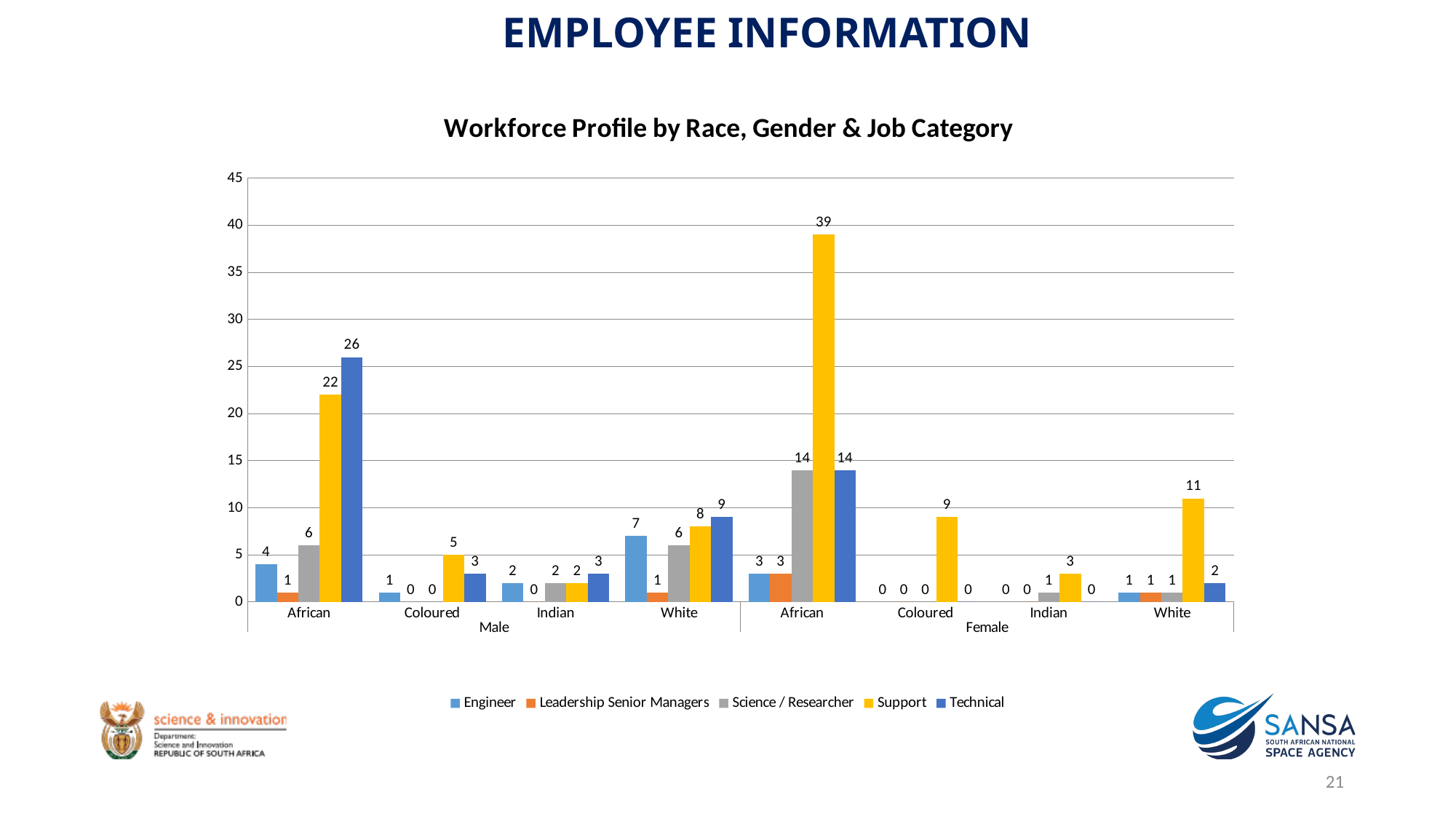
Which race and gender group has the highest Support value? African Female What kind of chart is shown on the slide? bar chart What is the difference between the Support values for African Female and African Male employees? 17 What is the Technical value for African Male employees? 26 How many series does the legend list? 5 What is the title of the chart? Workforce Profile by Race, Gender & Job Category Which is larger: the Technical value for White Male or the Technical value for White Female? White Male What is the Support value for African Female employees? 39 Is the Support value for African Female employees greater or less than 35? greater How many race and gender groups are shown on the x axis? 8 What is the Engineer value for White Male employees? 7 What is the Science / Researcher value for African Female employees? 14